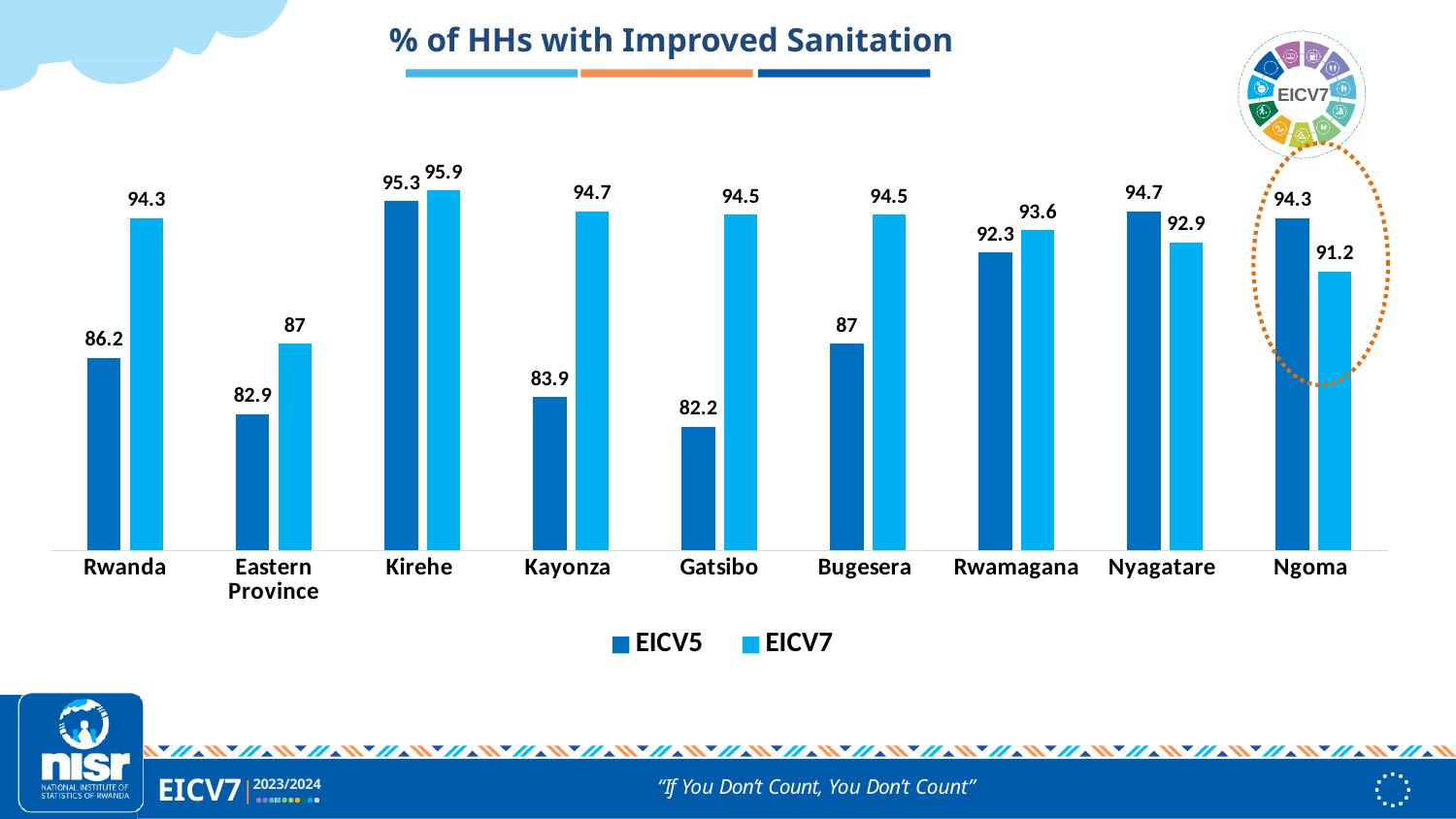
What is the EICV7 value for Kayonza? 94.7 Which category has the highest EICV7 value? Kirehe What is the difference between the EICV5 and EICV7 values for Ngoma? 3.1 What is the EICV5 value for Gatsibo? 82.2 What type of chart is shown on the slide? Bar chart What is the EICV7 value for Ngoma? 91.2 How many series does the legend list? 2 Which is larger, the EICV7 value for Eastern Province or the EICV7 value for Rwamagana? Rwamagana What is the difference between the EICV7 and EICV5 values for Gatsibo? 12.3 Which is larger for Nyagatare, the EICV5 value or the EICV7 value? EICV5 Which category has the lowest EICV5 value? Gatsibo How many categories are shown on the x axis? 9